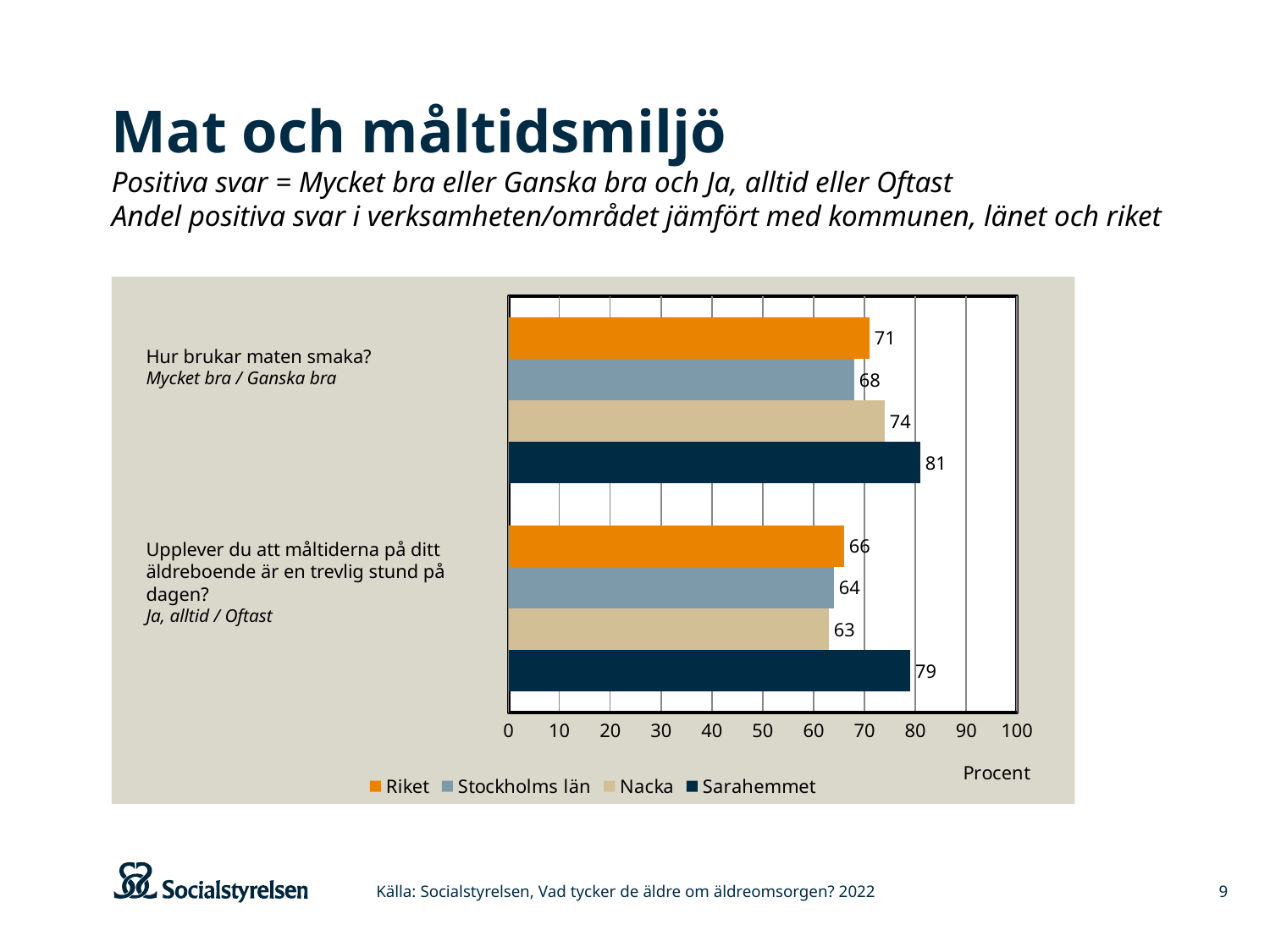
Is the value for Sarahemmet on "Upplever du att måltiderna på ditt äldreboende är en trevlig stund på dagen?" greater or less than 70? greater What is the difference between Sarahemmet and Riket for "Hur brukar maten smaka?"? 10 What value does Nacka have for "Upplever du att måltiderna på ditt äldreboende är en trevlig stund på dagen?"? 63 How many questions (categories) are shown in the chart? 2 Which is larger for "Upplever du att måltiderna på ditt äldreboende är en trevlig stund på dagen?": Riket or Nacka? Riket What value does Stockholms län have for "Hur brukar maten smaka?"? 68 Which series has the lowest value for "Hur brukar maten smaka?"? Stockholms län What kind of chart is shown on the slide? Bar chart How many series does the legend list? 4 Which series has the highest value for "Upplever du att måltiderna på ditt äldreboende är en trevlig stund på dagen?"? Sarahemmet What value does Sarahemmet have for "Hur brukar maten smaka?"? 81 What is the unit label shown below the x axis? Procent